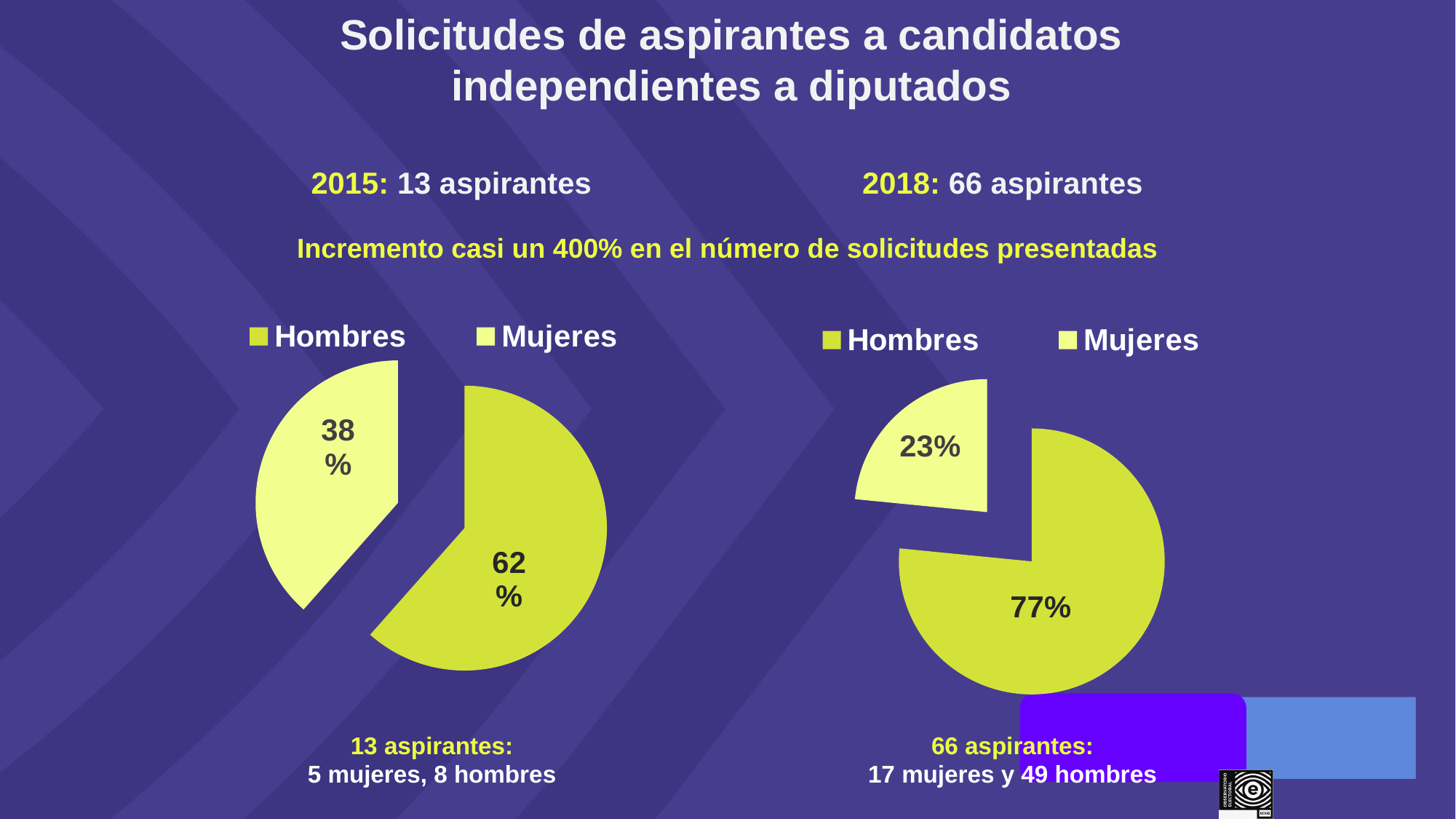
In the left pie chart (2015), which slice is the largest? Hombres Which is larger: the Mujeres share in the left pie chart (2015) or the Mujeres share in the right pie chart (2018)? Left pie chart (2015) What type of chart is used on the left side of the slide? Pie chart In the left pie chart (2015), what is the difference in percentage points between Hombres and Mujeres? 24 In the left pie chart (2015), what share of the pie is Hombres? 62% In the right pie chart (2018), what share of the pie is Mujeres? 23% In the right pie chart (2018), which slice is the smallest? Mujeres In the left pie chart (2015), what share of the pie is Mujeres? 38% How many slices does the right pie chart (2018) have? 2 How many entries does the legend of the left pie chart (2015) list? 2 In the right pie chart (2018), what is the difference in percentage points between Hombres and Mujeres? 54